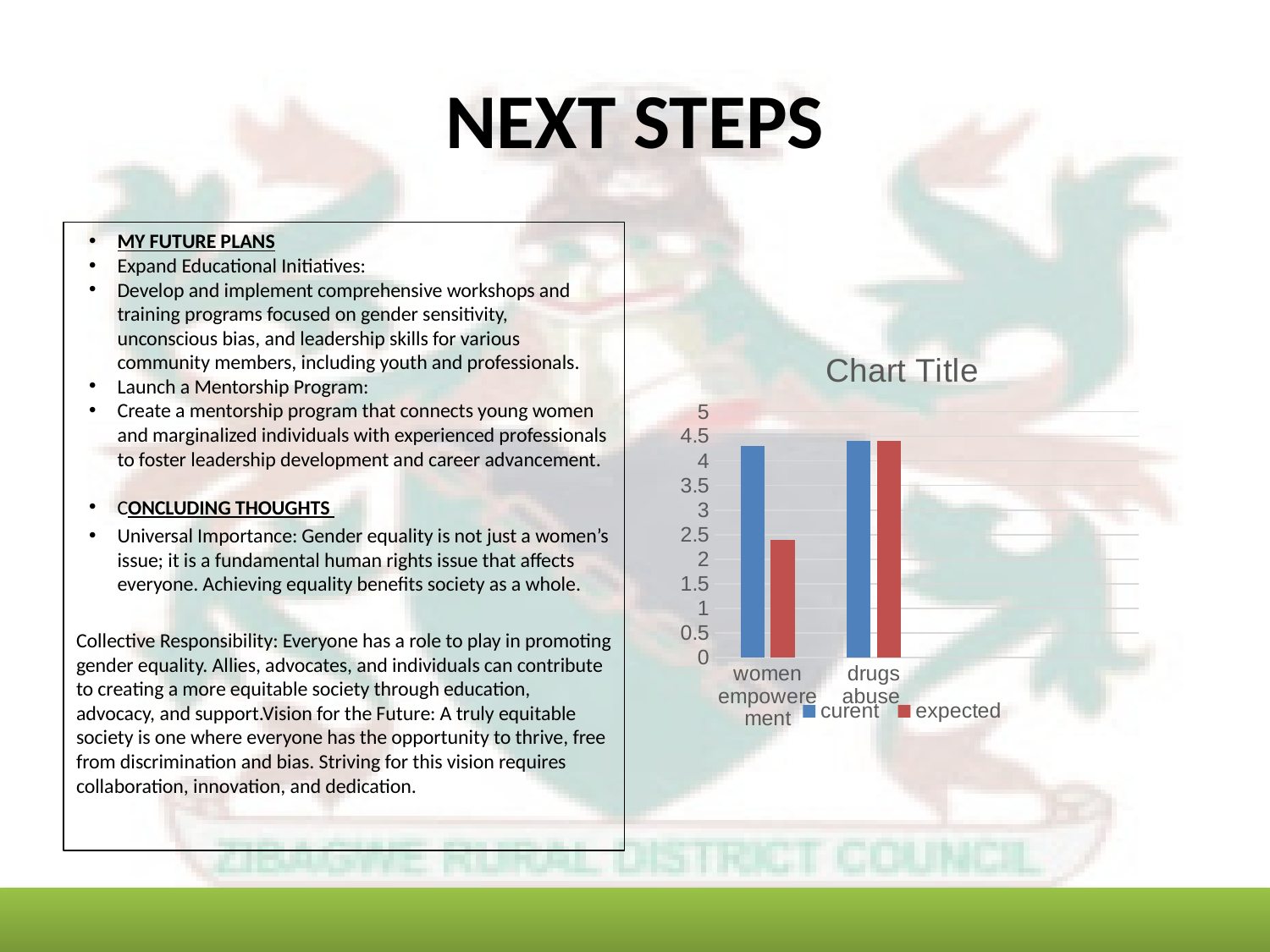
For women empowerement, which is larger: the curent value or the expected value? curent Is the expected value for women empowerement greater or less than 3? less Which bar in the chart is the lowest? expected for women empowerement Is the curent value for women empowerement greater or less than 4? greater Is the curent value for drugs abuse greater or less than 4? greater Which series is shown in blue in the chart? curent For the expected series, which category has the larger value: women empowerement or drugs abuse? drugs abuse What kind of chart is shown on the slide? bar chart What is the title of the chart? Chart Title How many categories are shown on the x axis of the chart? 2 How many series does the chart legend list? 2